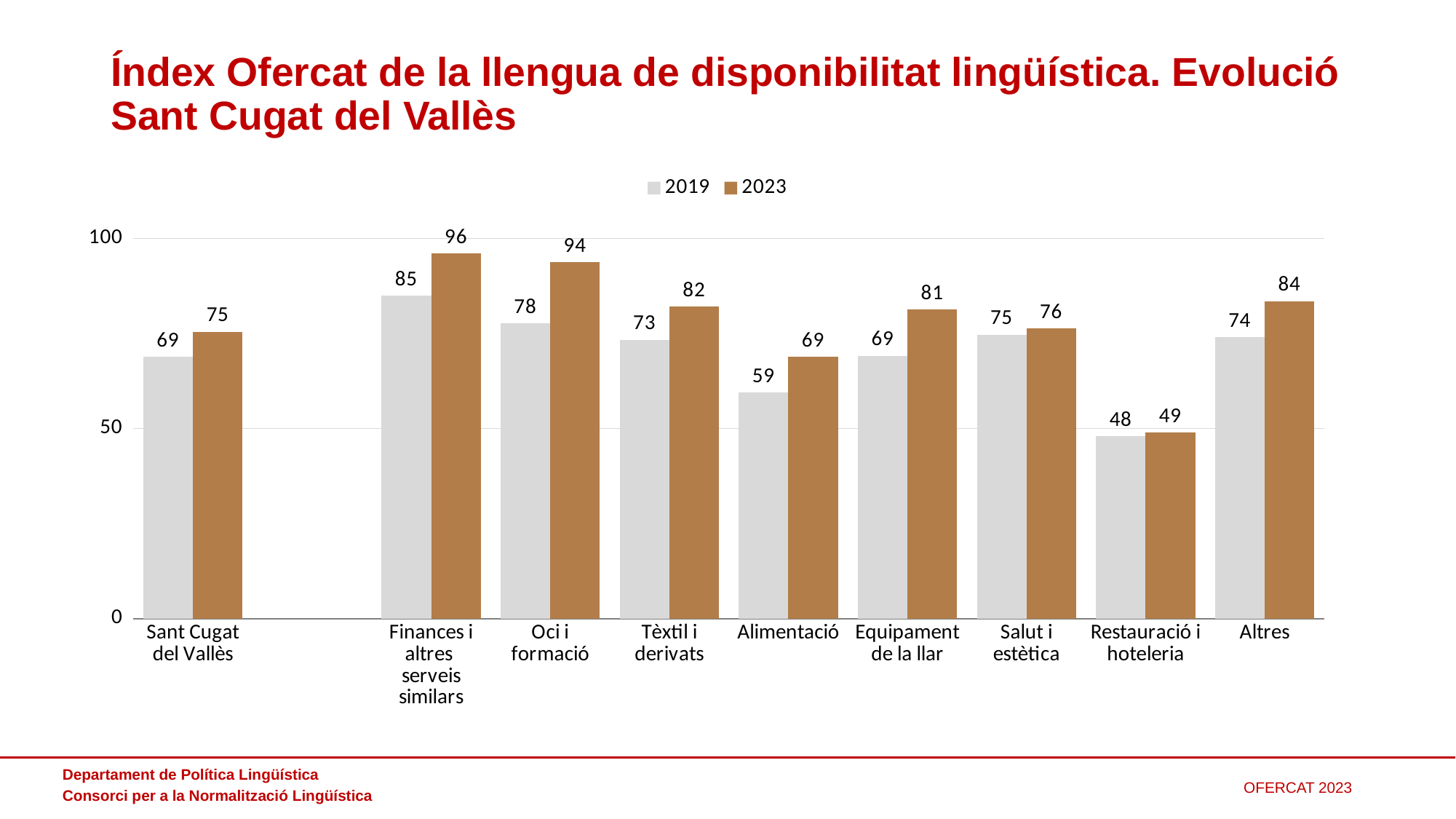
What is the difference between the 2023 and 2019 values for Alimentació? 10 Which category has the highest 2023 value? Finances i altres serveis similars Which is larger: the 2023 value for Equipament de la llar or the 2023 value for Salut i estètica? Equipament de la llar How many categories are shown on the x axis? 9 What is the 2023 value for Sant Cugat del Vallès? 75 What is the difference between the 2023 values for Oci i formació and Tèxtil i derivats? 12 How many series does the legend list? 2 What kind of chart is shown on the slide? bar chart Is the 2019 value for Restauració i hoteleria greater or less than 50? less What is the 2019 value for Alimentació? 59 What is the 2023 value for Finances i altres serveis similars? 96 Which category has the lowest 2019 value? Restauració i hoteleria